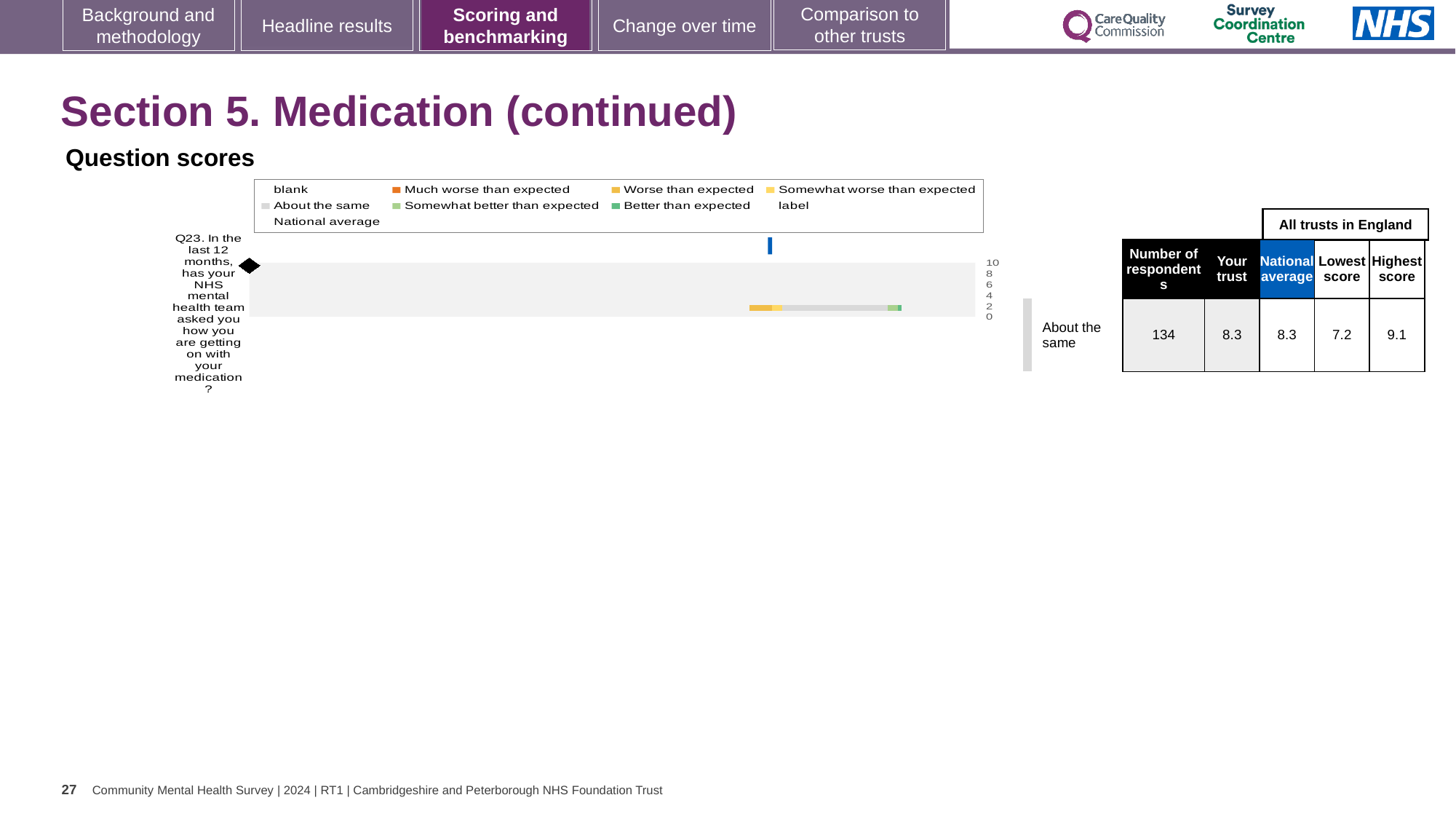
How many respondents answered Q23 about being asked how you are getting on with your medication? 134 By how much does the trust's Q23 score exceed the lowest score in England? 1.1 What is the difference between the highest and lowest trust scores for Q23? 1.9 Is the trust's score for Q23 higher than, lower than, or the same as the national average? the same What is the 'Your trust' score for Q23? 8.3 What is the national average score for Q23? 8.3 What is the lowest score among all trusts in England for Q23? 7.2 Which benchmarking category is the trust's Q23 score placed in? About the same What is the highest score among all trusts in England for Q23? 9.1 How many survey questions are plotted in the Question scores chart? 1 What kind of chart is used to show the Q23 question score? bar chart